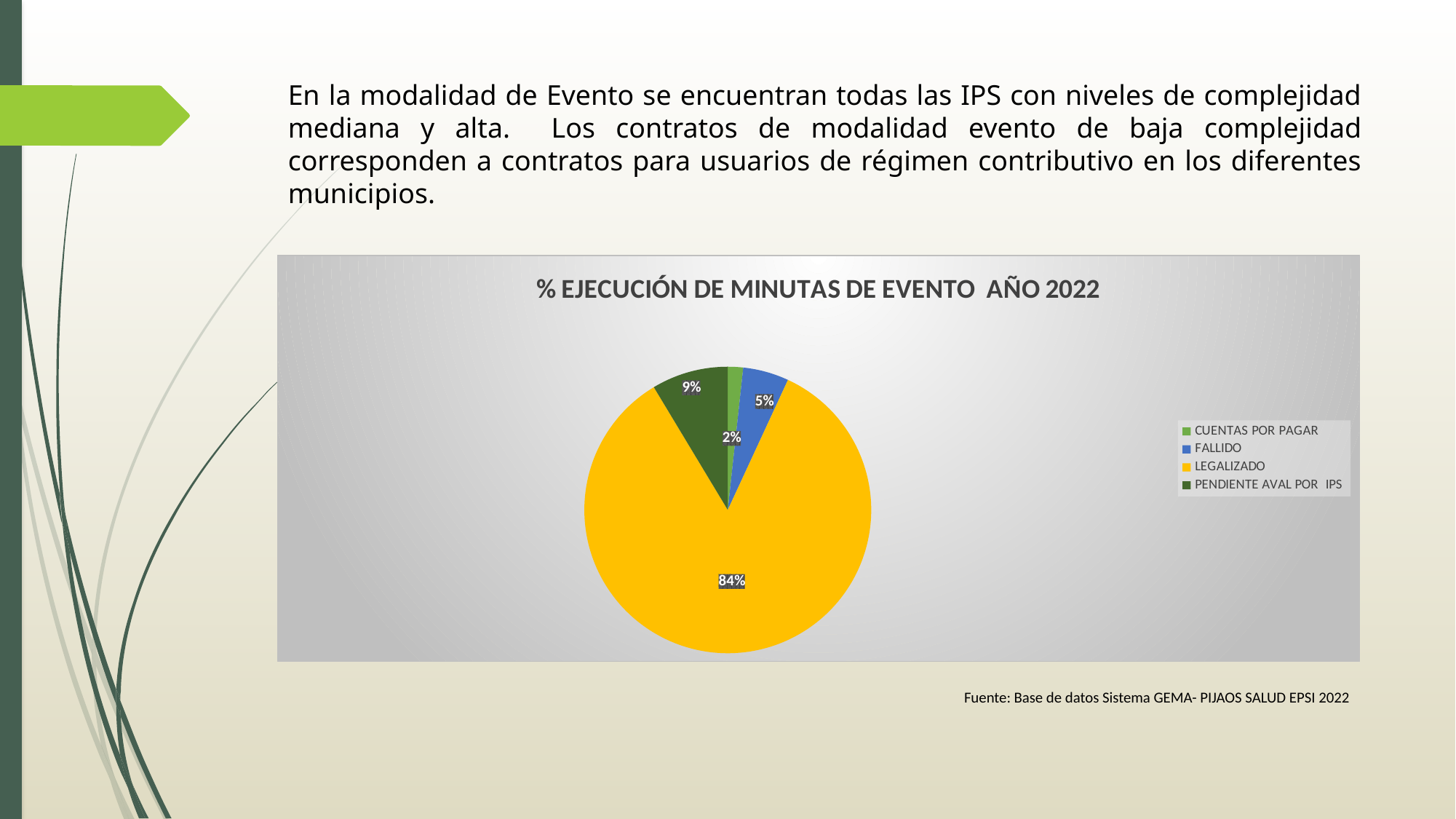
How many categories does the legend list? 4 What colour is the LEGALIZADO slice? yellow What percentage of the pie corresponds to PENDIENTE AVAL POR IPS? 9% What percentage of the pie corresponds to FALLIDO? 5% What percentage of the pie corresponds to LEGALIZADO? 84% Which is larger, the share for FALLIDO or the share for PENDIENTE AVAL POR IPS? PENDIENTE AVAL POR IPS What percentage of the pie corresponds to CUENTAS POR PAGAR? 2% What is the difference in percentage points between LEGALIZADO and PENDIENTE AVAL POR IPS? 75 What is the title of the chart? % EJECUCIÓN DE MINUTAS DE EVENTO AÑO 2022 What type of chart is shown on the slide? pie chart Which category has the largest share of the pie? LEGALIZADO Which category has the smallest share of the pie? CUENTAS POR PAGAR